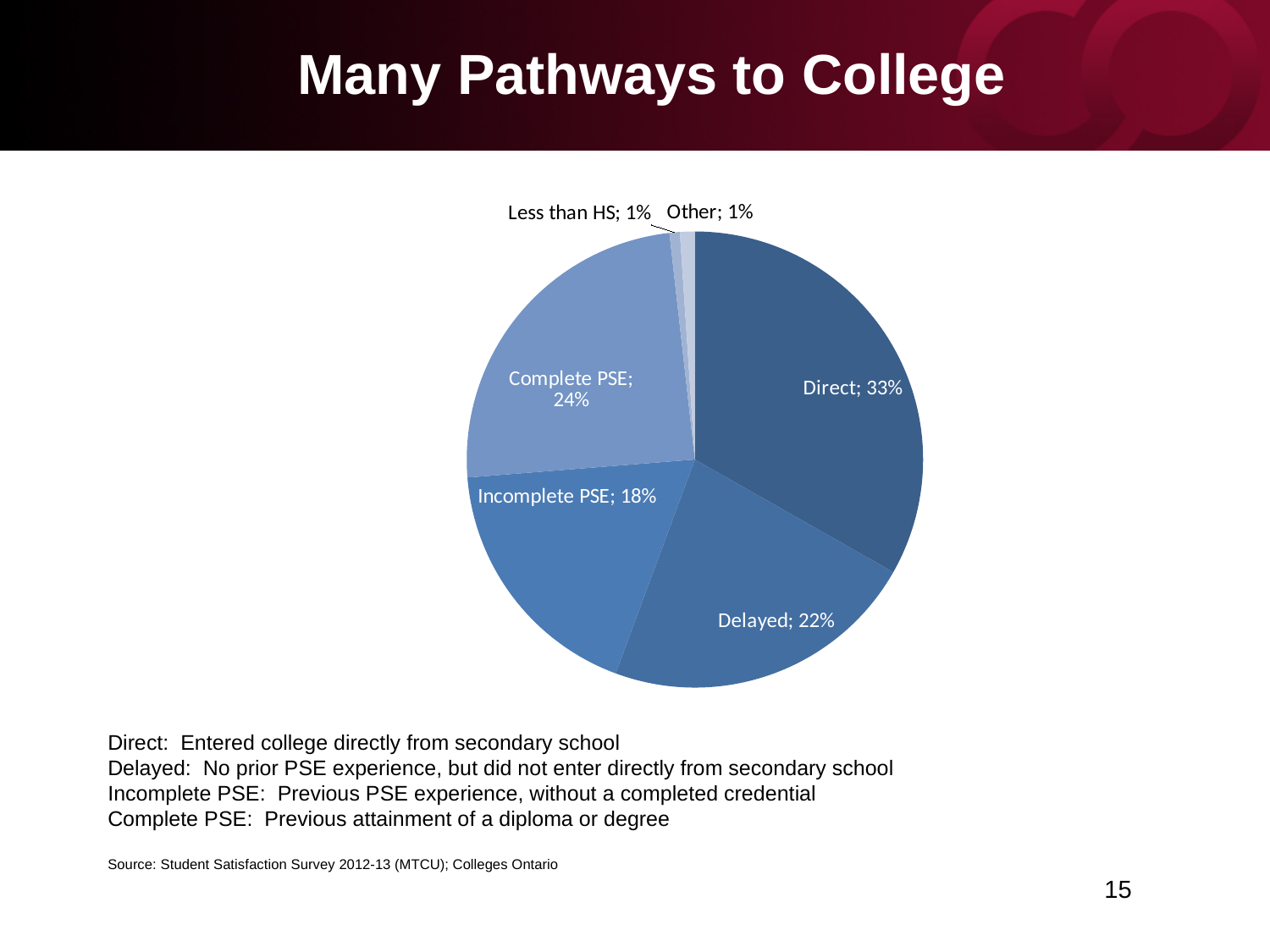
Which category has the largest slice of the pie? Direct How many slices does the pie chart have? 6 What is the difference in percentage points between the Direct and Delayed slices? 11 What share of the pie is labelled Complete PSE? 24% What is the combined share of the Delayed and Incomplete PSE slices? 40% What share of the pie is labelled Direct? 33% What is the title of the slide containing the pie chart? Many Pathways to College Which slice is larger, Complete PSE or Incomplete PSE? Complete PSE What share of the pie is labelled Incomplete PSE? 18% What kind of chart is shown on the slide? pie chart What share of the pie is labelled Delayed? 22% What share of the pie is labelled Less than HS? 1%